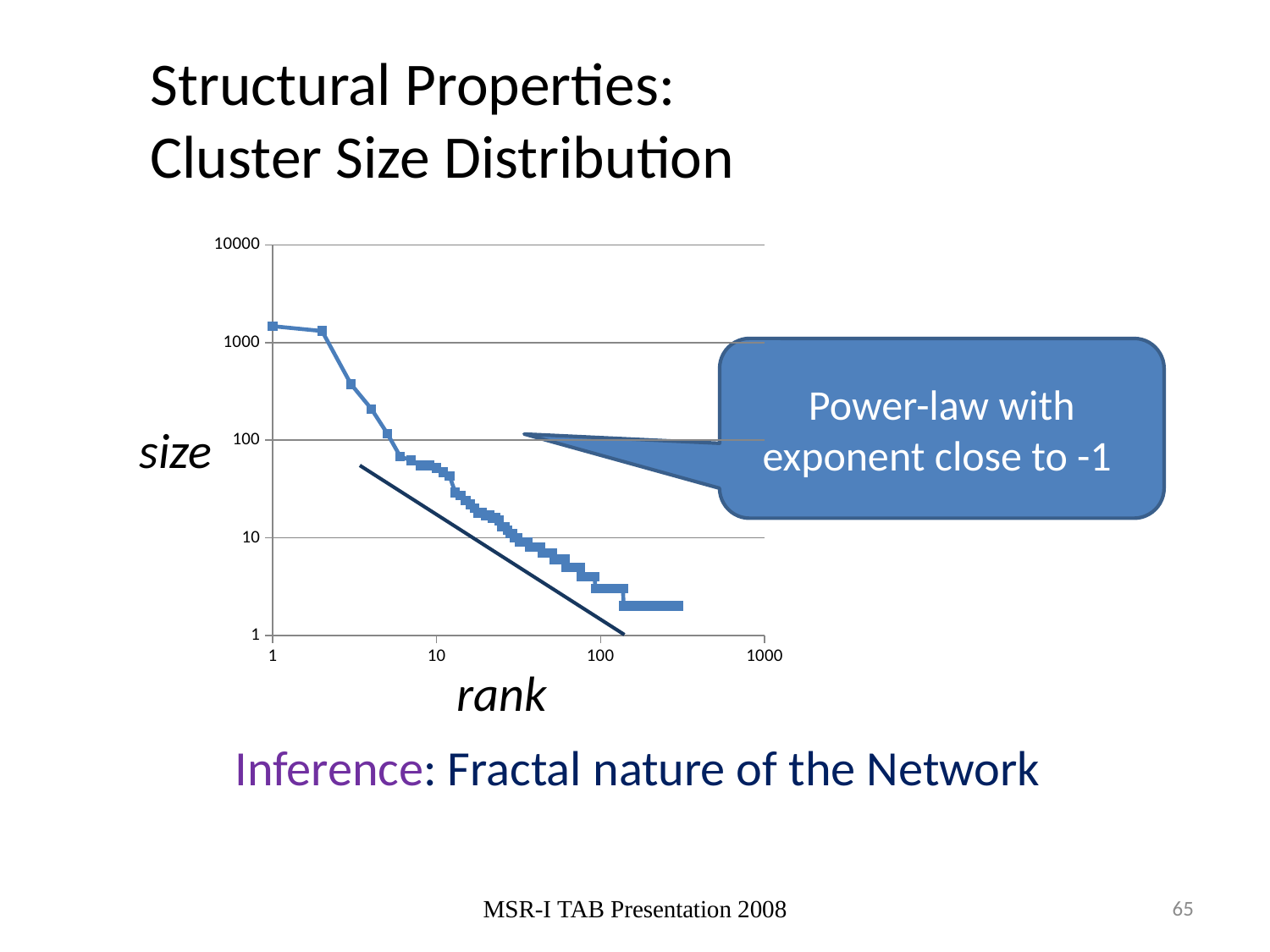
What kind of chart is shown on the slide? line chart Is the size value at rank 100 greater or less than 10? less Which is larger, the size at rank 100 or the size at rank 10? rank 10 At which rank is the plotted size highest? 1 Is the size value at rank 10 greater or less than 100? less What is the label of the x axis of the chart? rank What is the label of the y axis of the chart? size Is the size value at rank 2 greater or less than 1000? greater Do the plotted size values rise or fall as rank increases along the x axis? fall Which is larger, the size at rank 1 or the size at rank 10? rank 1